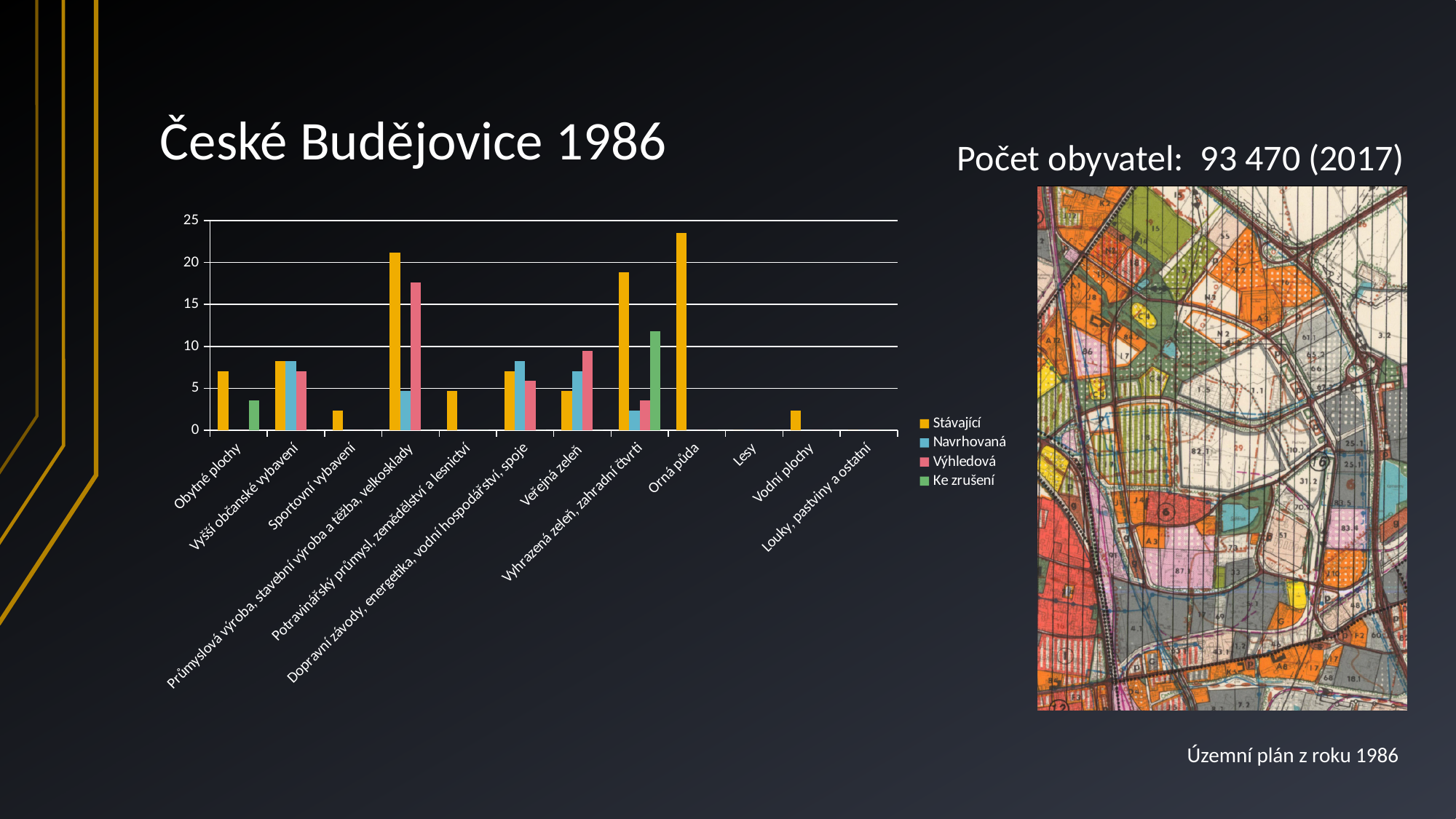
For Veřejná zeleň, which is larger: the Stávající value or the Výhledová value? Výhledová For Průmyslová výroba, stavební výroba a těžba, velkosklady, which is larger: the Stávající value or the Výhledová value? Stávající Which category has the highest Výhledová value? Průmyslová výroba, stavební výroba a těžba, velkosklady Which category has the highest Ke zrušení value? Vyhrazená zeleň, zahradní čtvrti Is the Stávající value for Orná půda greater or less than 20? greater How many series does the chart legend list? 4 What are the four series listed in the chart legend? Stávající, Navrhovaná, Výhledová, Ke zrušení Is the Výhledová value for Průmyslová výroba, stavební výroba a těžba, velkosklady greater or less than 15? greater How many categories are shown on the x axis of the chart? 12 Is the Stávající value for Sportovní vybavení greater or less than 5? less Which category has the highest Stávající value? Orná půda What kind of chart is shown on the slide? bar chart